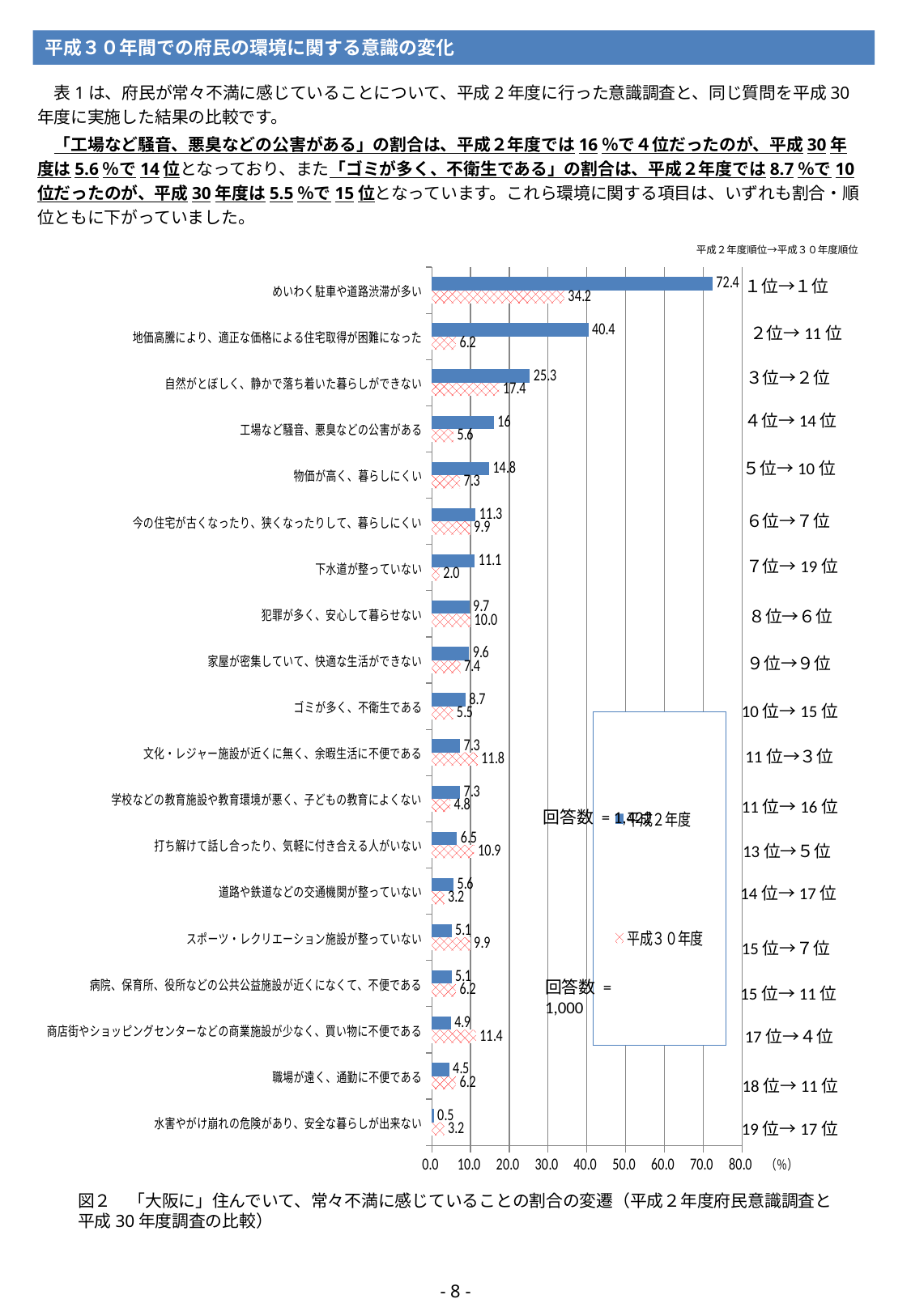
What is the difference between the 平成2年度 and 平成30年度 values for 「工場など騒音、悪臭などの公害がある」? 10.4 What type of chart is shown on the slide? bar chart Is the 平成2年度 value for 「地価高騰により、適正な価格による住宅取得が困難になった」 greater or less than 30.0? greater How many series does the chart's legend list? 2 For 「文化・レジャー施設が近くに無く、余暇生活に不便である」, which is larger: the 平成2年度 value or the 平成30年度 value? 平成30年度 What is the 平成2年度 value for 「めいわく駐車や道路渋滞が多い」? 72.4 How many categories are plotted in the chart? 19 Which category has the lowest 平成2年度 value? 水害やがけ崩れの危険があり、安全な暮らしが出来ない What is the 平成30年度 value for 「商店街やショッピングセンターなどの商業施設が少なく、買い物に不便である」? 11.4 What is the 平成30年度 value for 「下水道が整っていない」? 2.0 Which category has the highest 平成30年度 value? めいわく駐車や道路渋滞が多い What unit is shown at the end of the horizontal axis? (%)